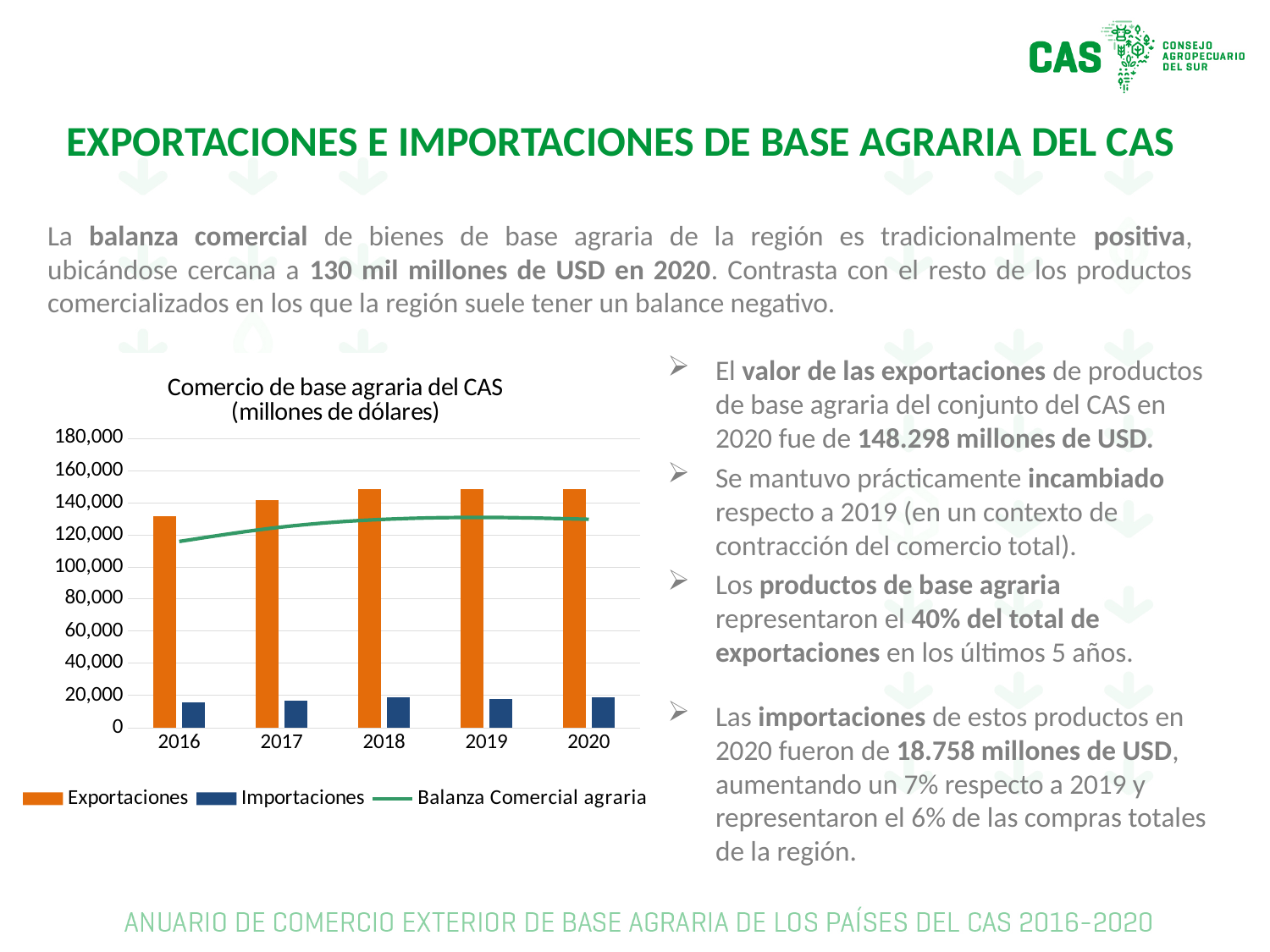
Is the value of Balanza Comercial agraria for 2016 greater or less than 100,000? greater How many series does the chart legend list? 3 What is the title of the chart? Comercio de base agraria del CAS (millones de dólares) Is the value of Exportaciones for 2016 greater or less than 120,000? greater Is the value of Importaciones for 2020 greater or less than 20,000? less Which is larger, Exportaciones in 2016 or Exportaciones in 2018? Exportaciones in 2018 How many years are shown on the x axis of the chart? 5 Do the Exportaciones values rise or fall from 2016 to 2018? rise In which year is the value of Exportaciones lowest? 2016 What kind of chart is shown on the slide? Bar chart with a line Which series is drawn as a green line in the chart? Balanza Comercial agraria